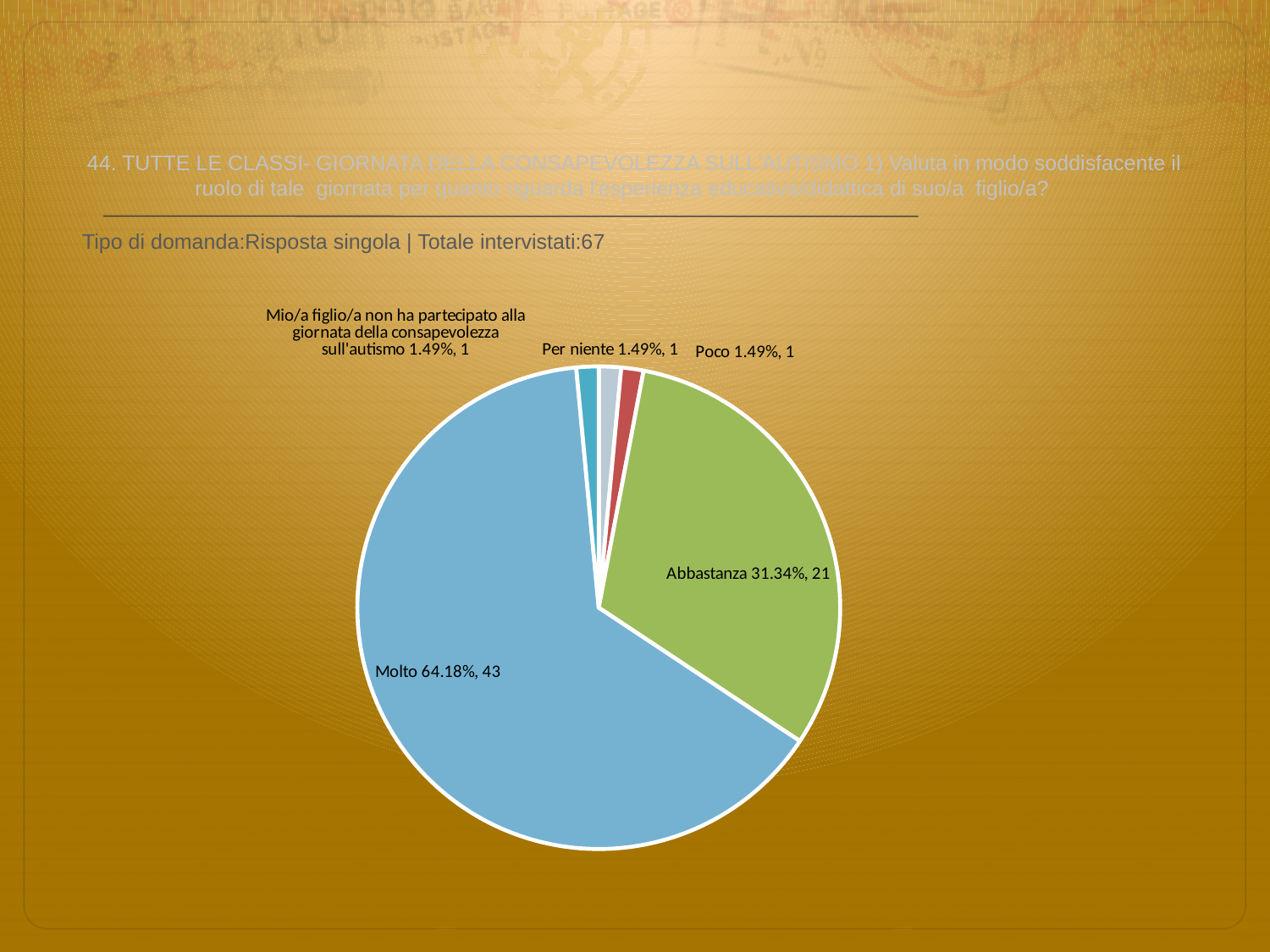
How many respondents answered "Abbastanza"? 21 Which category has the largest share of the pie? Molto What colour is the "Molto" slice of the pie? Blue What percentage of respondents answered "Molto"? 64.18% What percentage of respondents answered "Abbastanza"? 31.34% What kind of chart is shown on the slide? Pie chart Which is larger, the share for "Abbastanza" or the share for "Poco"? Abbastanza How many respondents answered "Poco"? 1 How many slices does the pie chart have? 5 What is the total number of respondents (Totale intervistati) stated on the slide? 67 What percentage is shown for "Per niente"? 1.49% What is the difference in number of respondents between "Molto" and "Abbastanza"? 22